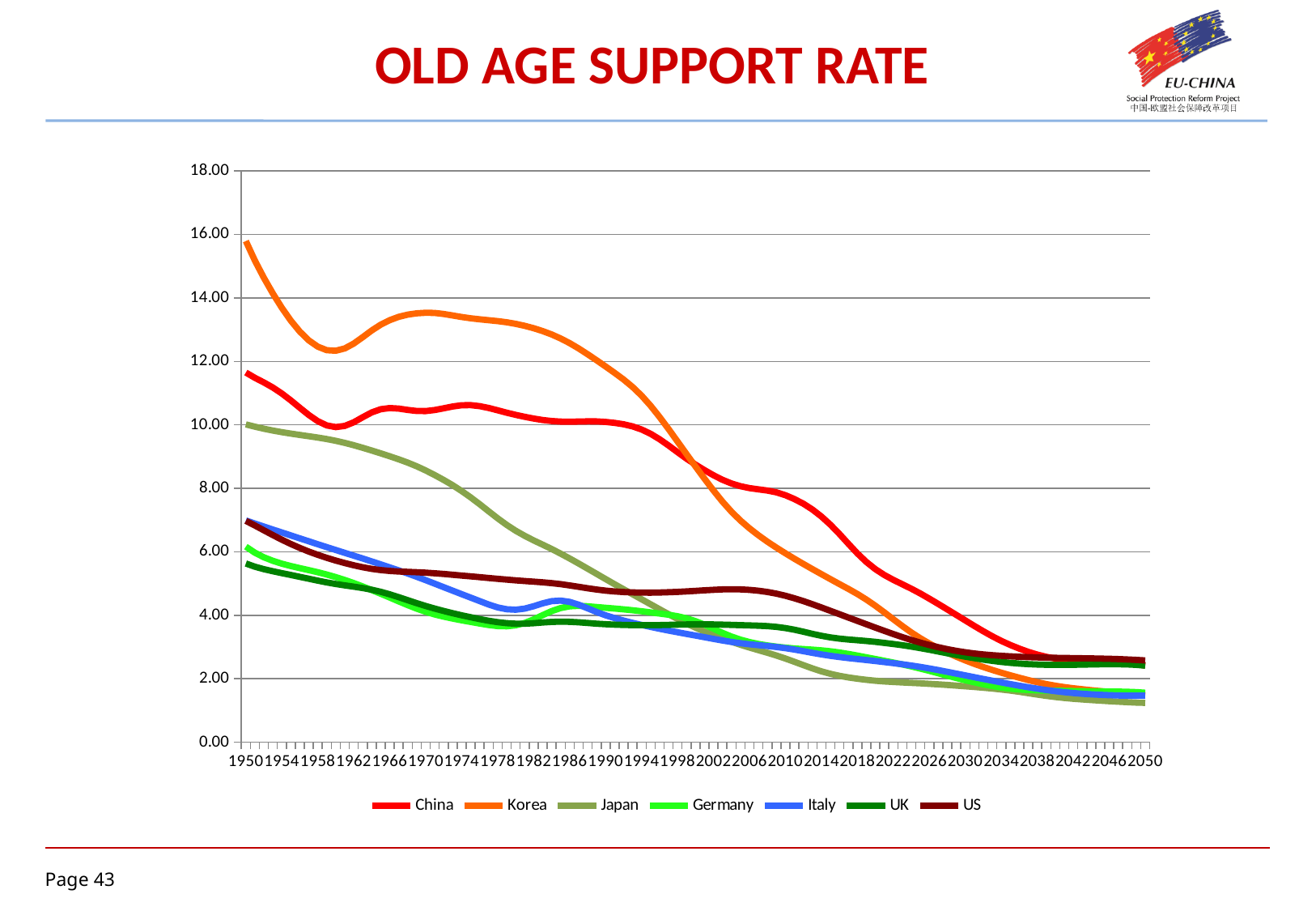
What kind of chart is shown on the slide? line chart Does the China line rise or fall overall from 1950 to 2050? falls Is the value for China in 1950 greater or less than 12.00? less Is the value for Korea in 1950 greater or less than 14.00? greater Which series has the highest value in 1950? Korea How many series does the legend list? 7 Is the value for US in 2050 greater or less than 2.00? greater Which series has the lowest value in 2050? Japan In 2010, which series has the higher value, China or Korea? China What is the title of the chart? OLD AGE SUPPORT RATE In 2050, which series has the higher value, US or Japan? US